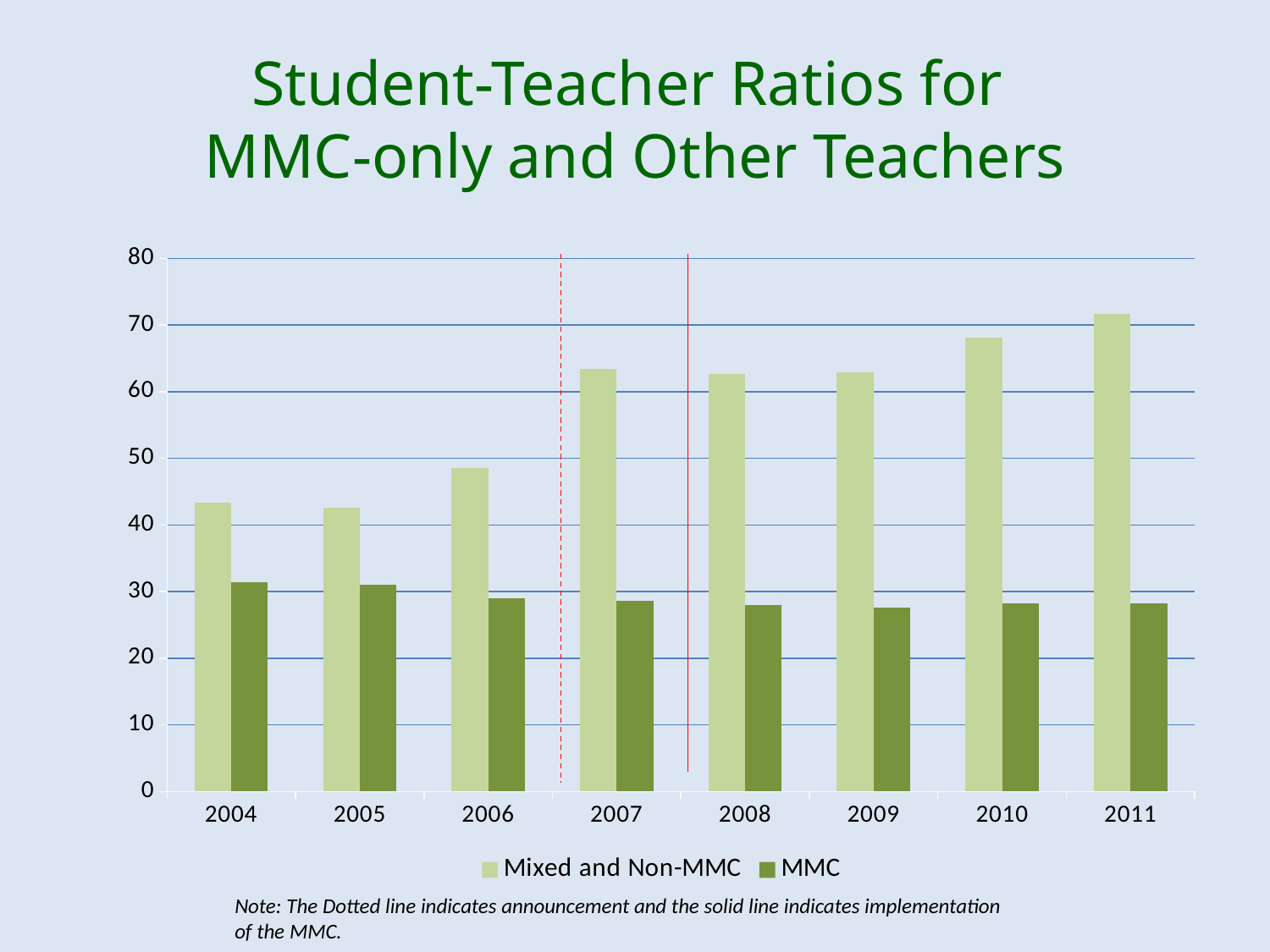
Is the Mixed and Non-MMC value for 2011 greater or less than 70? greater In which year is the Mixed and Non-MMC value highest? 2011 Which is larger: the Mixed and Non-MMC value for 2006 or for 2007? 2007 How many series does the legend list? 2 What kind of chart is shown on the slide? bar chart Is the MMC value for 2009 greater or less than 30? less How many years are shown on the x axis? 8 Is the MMC value for 2004 greater or less than 30? greater Which is larger: the MMC value for 2004 or for 2011? 2004 Does the Mixed and Non-MMC series generally rise or fall from 2004 to 2011? rise